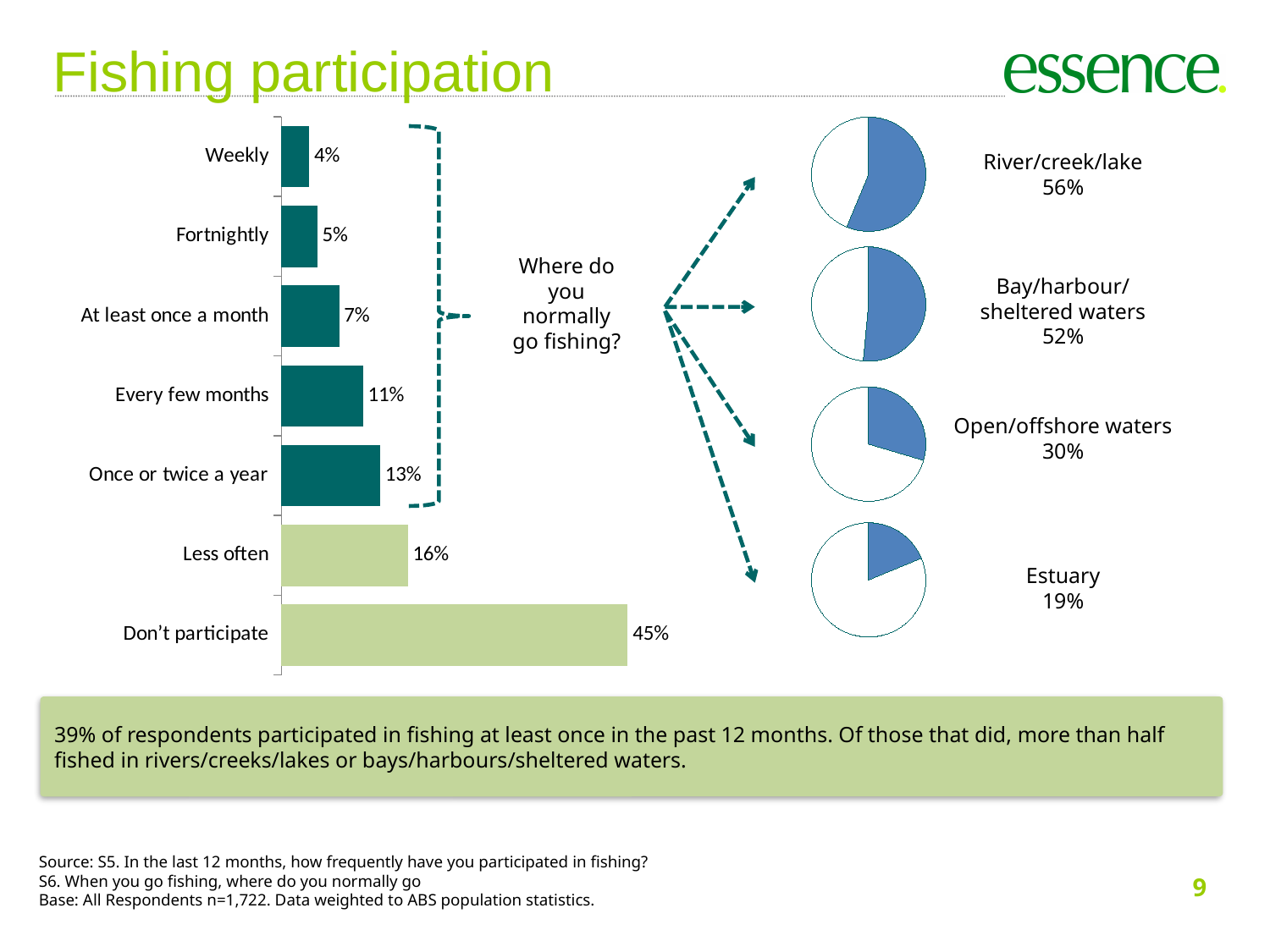
What kind of chart is shown on the left of the slide? Bar chart In the bar chart on the left, what is the difference between 'Less often' and 'Every few months'? 5% In the bar chart on the left, which category has the highest value? Don't participate How many categories does the bar chart on the left show? 7 In the bar chart on the left, which category has the lowest value? Weekly In the bar chart on the left, what percentage of respondents fish weekly? 4% In the bar chart on the left, which is larger: 'Once or twice a year' or 'At least once a month'? Once or twice a year In the bar chart on the left, do the values rise or fall going from 'Weekly' down to 'Don't participate'? Rise In the pie charts on the right, which fishing location has the smallest share? Estuary In the bar chart on the left, what percentage of respondents don't participate in fishing? 45% In the pie charts on the right, what is the difference between the River/creek/lake share and the Estuary share? 37% In the pie charts on the right, what share of respondents normally fish in open/offshore waters? 30%